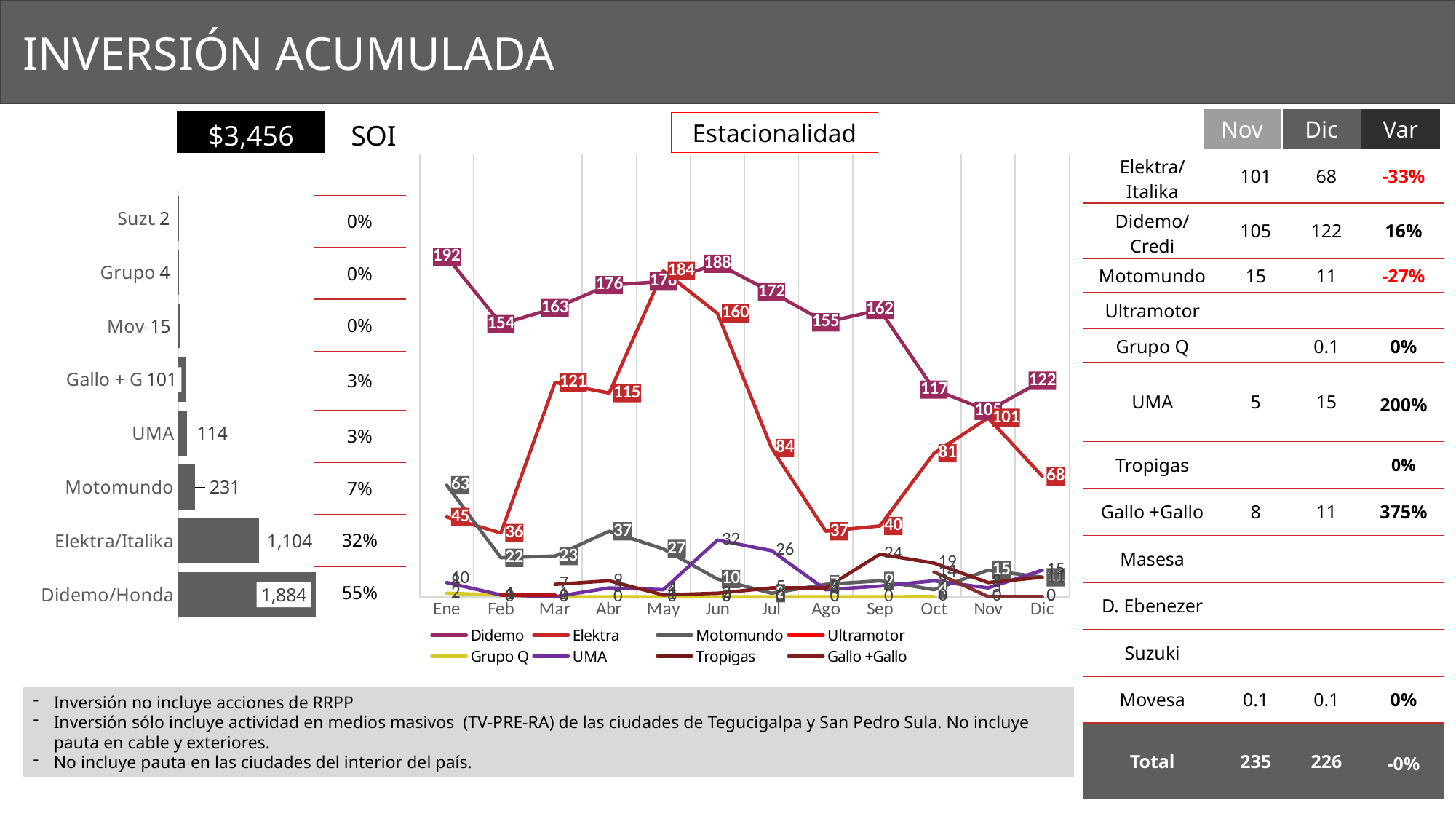
In the Estacionalidad chart, what is the difference between Elektra in Nov and Elektra in Dic? 33 How many series does the legend of the Estacionalidad chart list? 8 In the left bar chart, what is the difference between Didemo/Honda and Elektra/Italika? 780 What type of chart is the Estacionalidad chart? line chart In the Estacionalidad chart, what is the value for Elektra in May? 184 In the Estacionalidad chart, what is the value for Didemo in Ene? 192 In the Estacionalidad chart, in which month does Didemo reach its lowest value? Nov In the left bar chart, what percentage share is shown next to Motomundo? 7% In the left bar chart, what is the value for Didemo/Honda? 1,884 In the Estacionalidad chart, which is larger in Dic: Didemo or Elektra? Didemo In the left bar chart, what is the value for Elektra/Italika? 1,104 In the left bar chart, which category has the highest value? Didemo/Honda